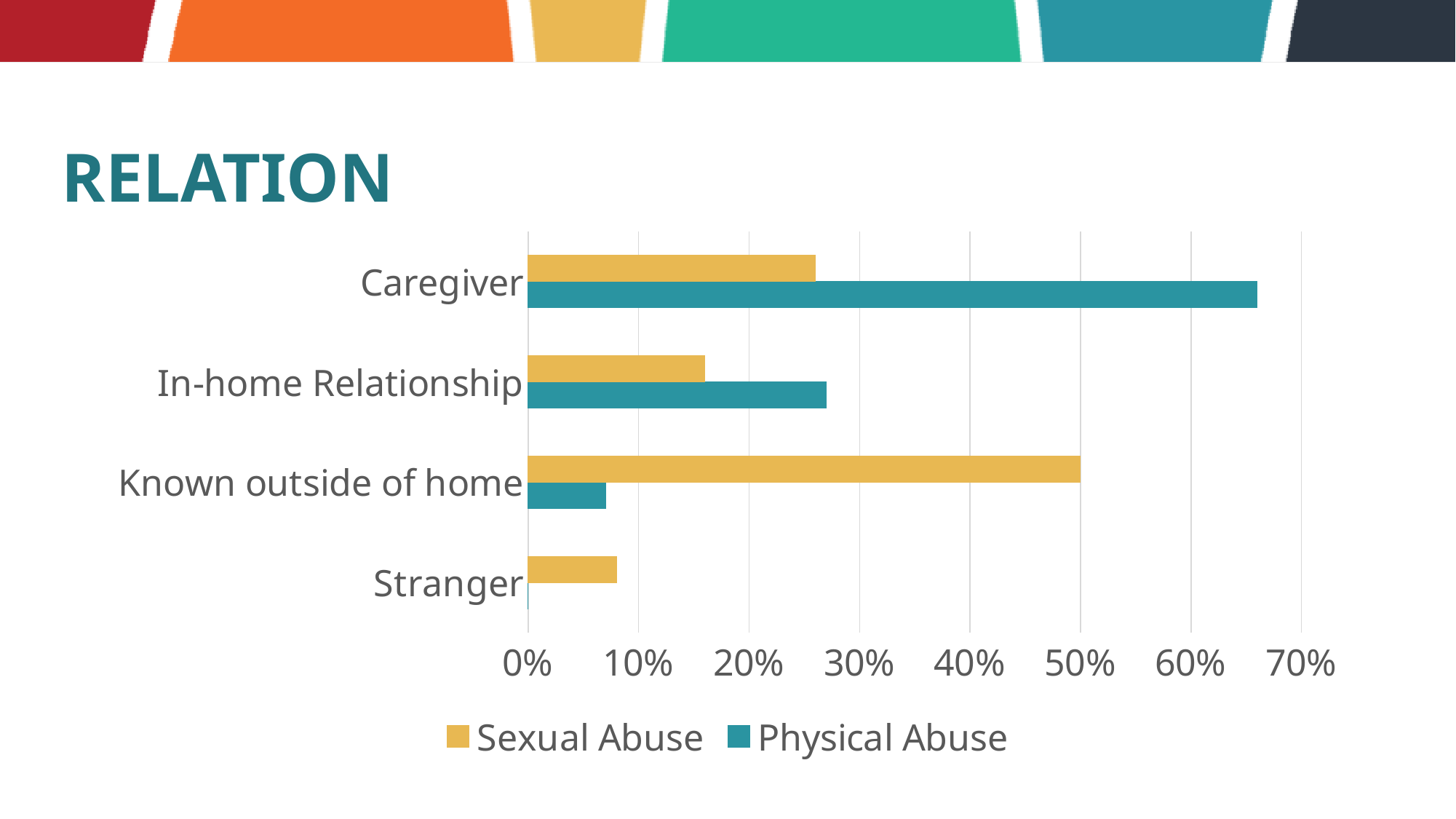
Which category has the lowest Sexual Abuse value? Stranger Is the Sexual Abuse value for Stranger greater or less than 10%? less What kind of chart is shown on the slide? bar chart For Caregiver, which is larger: Sexual Abuse or Physical Abuse? Physical Abuse Which category has the highest Sexual Abuse value? Known outside of home What is the title of the slide containing the chart? RELATION Is the Physical Abuse value for In-home Relationship greater or less than 20%? greater Is the Physical Abuse value for Caregiver greater or less than 60%? greater Which category has the highest Physical Abuse value? Caregiver How many series does the legend list? 2 How many relation categories are plotted on the chart? 4 For Known outside of home, which is larger: Sexual Abuse or Physical Abuse? Sexual Abuse